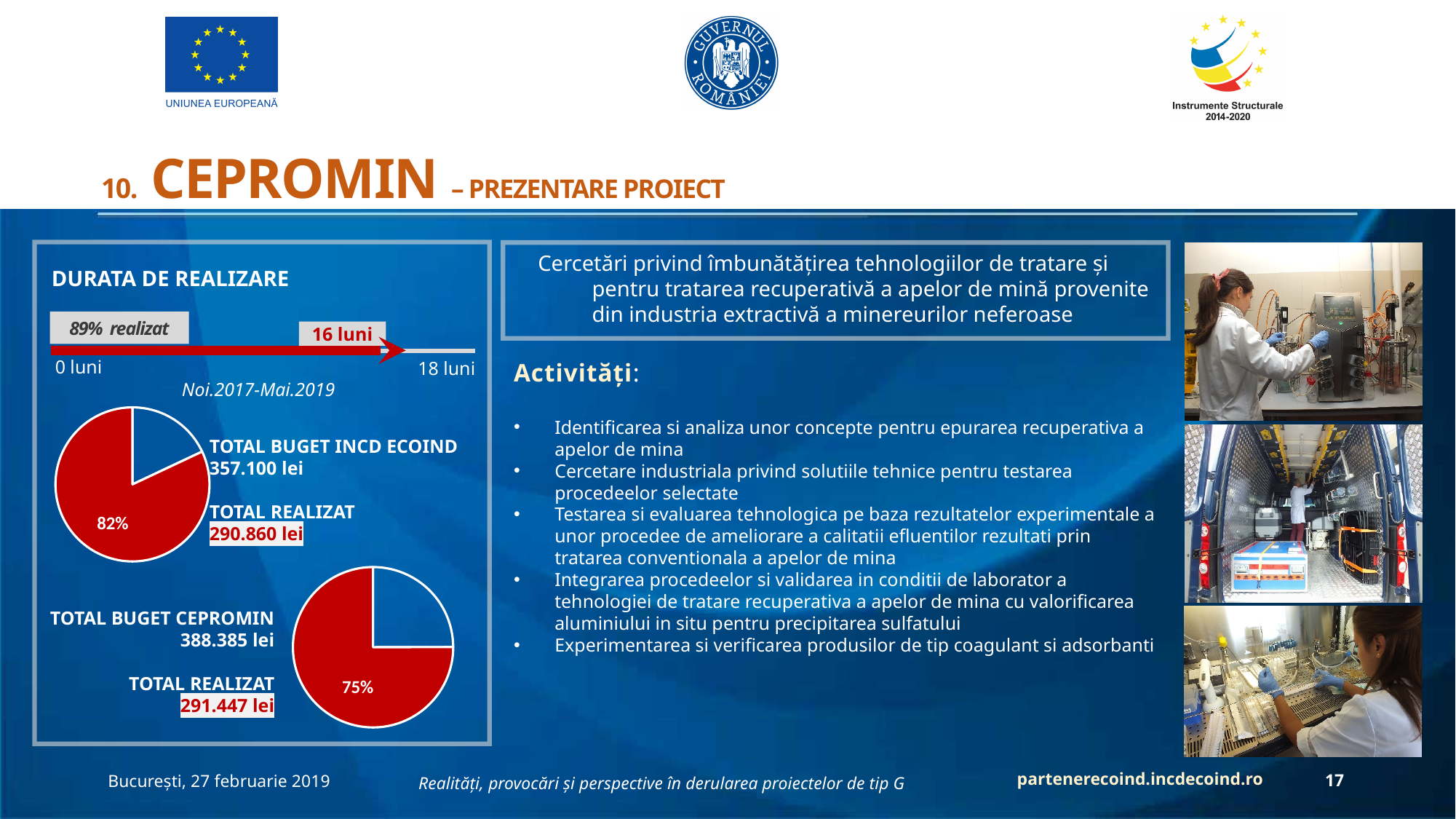
In the upper pie chart (INCD ECOIND), what share of the budget is shown as realized? 82% What kind of chart is used to show the budget realization for INCD ECOIND and CEPROMIN? pie chart What colour is the realized slice in the pie charts? red In the lower pie chart (CEPROMIN), what share of the budget is shown as realized? 75% What is the difference between TOTAL BUGET CEPROMIN and its TOTAL REALIZAT? 96.938 lei What is the TOTAL REALIZAT for CEPROMIN shown next to the lower pie chart? 291.447 lei What is the TOTAL REALIZAT for INCD ECOIND shown next to the upper pie chart? 290.860 lei What is the TOTAL BUGET CEPROMIN shown next to the lower pie chart? 388.385 lei What is the difference between TOTAL BUGET INCD ECOIND and its TOTAL REALIZAT? 66.240 lei What is the TOTAL BUGET INCD ECOIND shown next to the upper pie chart? 357.100 lei How many pie charts are shown on the slide? 2 Which pie chart shows the larger realized share, INCD ECOIND or CEPROMIN? INCD ECOIND